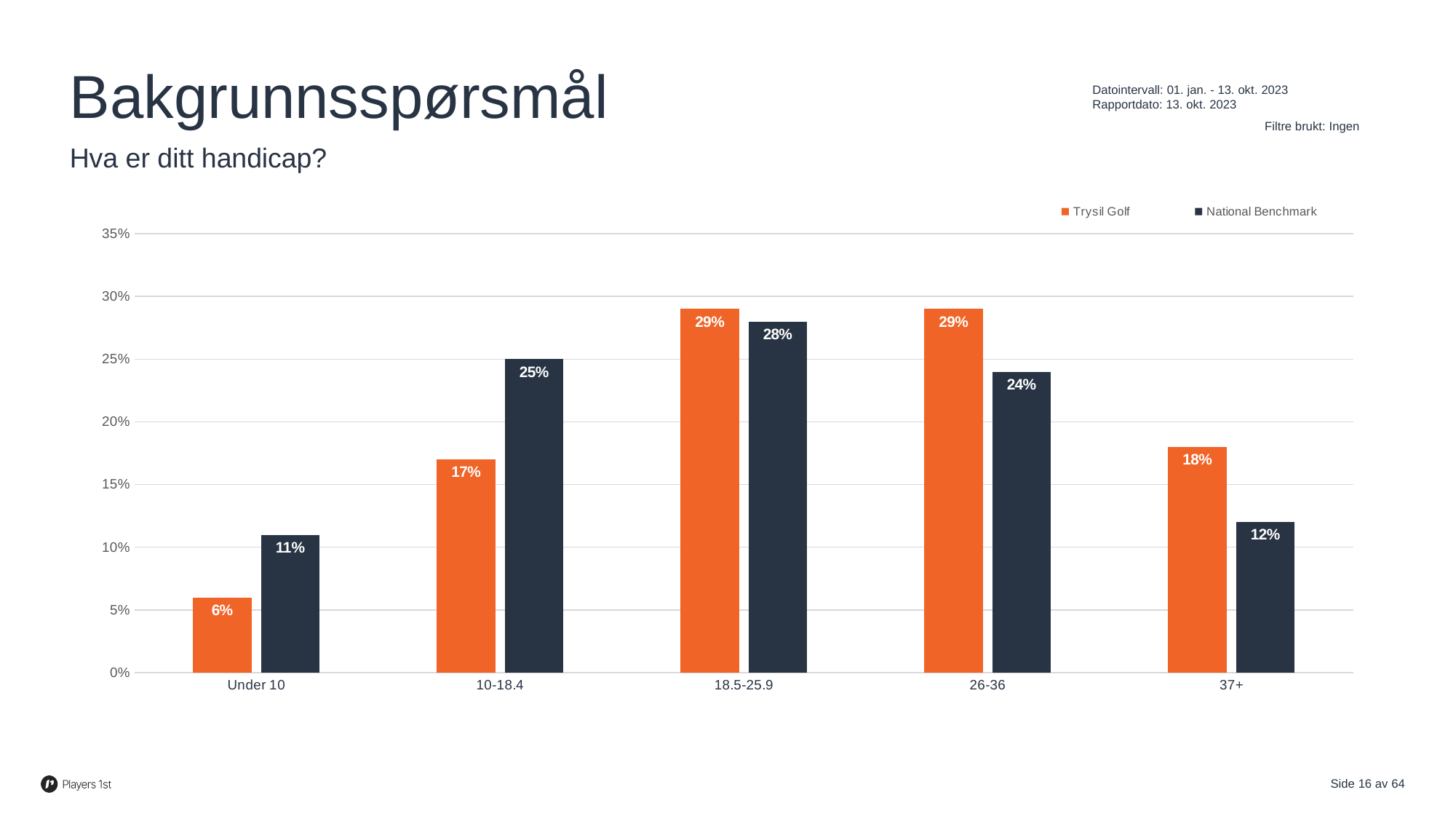
For the 26-36 category, which is larger: Trysil Golf or National Benchmark? Trysil Golf Which handicap category has the highest National Benchmark value? 18.5-25.9 How many series does the legend list? 2 What kind of chart is shown on the slide? Bar chart Which handicap category has the lowest Trysil Golf value? Under 10 What is the Trysil Golf value for the Under 10 category? 6% What is the Trysil Golf value for the 10-18.4 handicap category? 17% What is the National Benchmark value for the 37+ handicap category? 12% What is the difference between the Trysil Golf and National Benchmark values for the 37+ category? 6% What is the difference between the Trysil Golf and National Benchmark values for the 10-18.4 category? 8% For the Under 10 category, which is larger: Trysil Golf or National Benchmark? National Benchmark How many handicap categories are shown on the x axis? 5